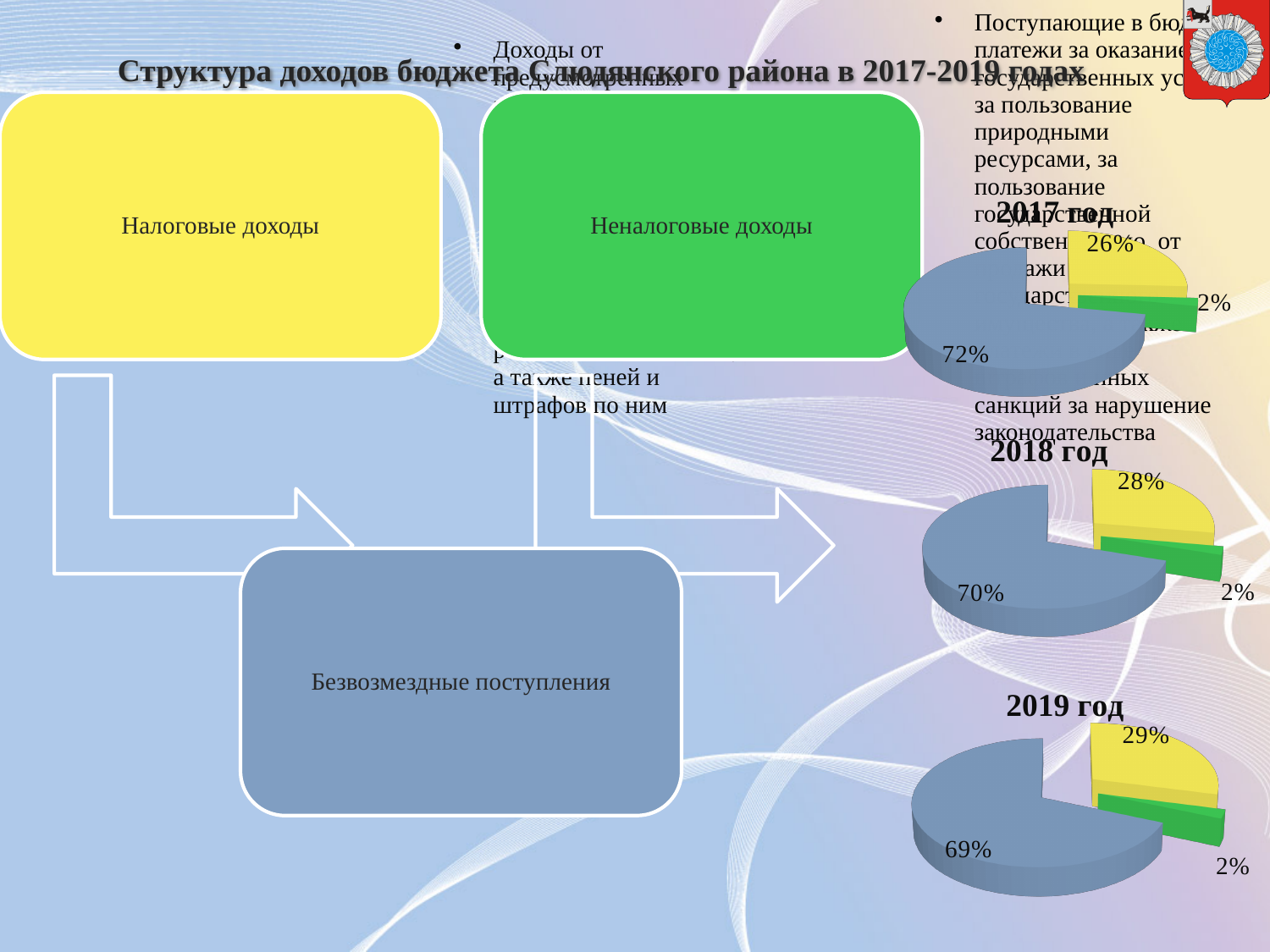
On the pie chart titled "2019 год", what is the value of the green slice? 2% Which is larger: the yellow slice on the "2018 год" chart or the yellow slice on the "2019 год" chart? 2019 год On the pie chart titled "2018 год", what is the value of the yellow slice? 28% What kind of chart is used for the "2018 год" chart? Pie chart On the pie chart titled "2017 год", what is the value of the largest (blue) slice? 72% On the pie chart titled "2018 год", which slice is the smallest and what is its value? The green slice, 2% Across the three pie charts from 2017 to 2019, does the blue slice's share rise or fall? Fall On the pie chart titled "2017 год", what is the difference between the blue slice and the yellow slice? 46 percentage points On the pie chart titled "2019 год", what is the value of the blue slice? 69% How many slices does the pie chart titled "2017 год" have? 3 What is the title of the bottom-most pie chart on the slide? 2019 год On the pie chart titled "2017 год", what is the value of the yellow slice? 26%